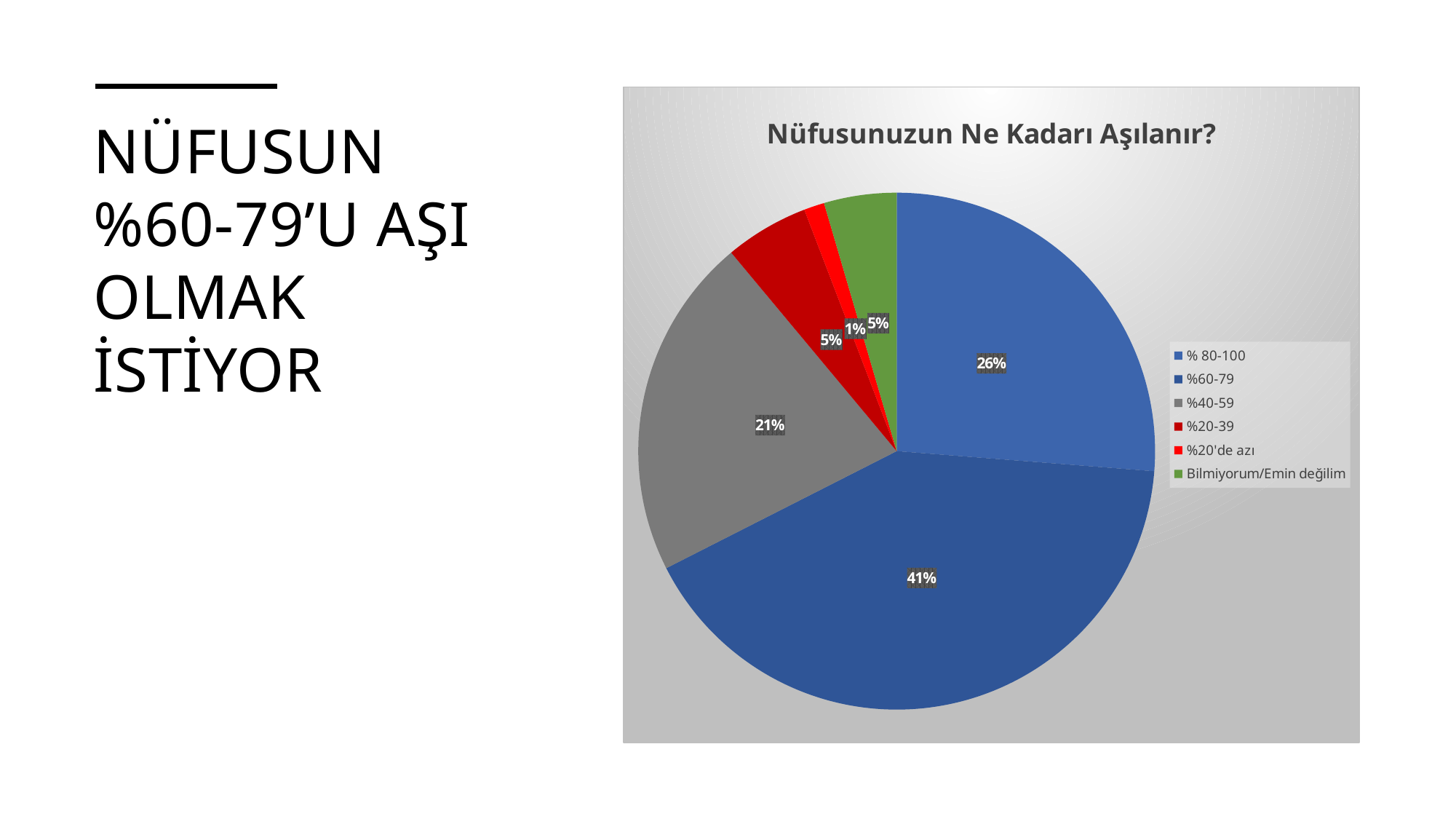
What kind of chart is shown on the slide? Pie chart What is the value shown for the Bilmiyorum/Emin değilim slice? 5% Which category has the largest slice of the pie? %60-79 How many categories does the legend list? 6 What is the value shown for the % 80-100 slice? 26% What is the value shown for the %20'de azı slice? 1% What is the difference between the %60-79 slice and the % 80-100 slice? 15% Which category has the smallest slice of the pie? %20'de azı What share of the pie does the %60-79 slice represent? 41% Which is larger, the %40-59 slice or the %20-39 slice? %40-59 What is the value shown for the %40-59 slice? 21% What is the title of the chart? Nüfusunuzun Ne Kadarı Aşılanır?